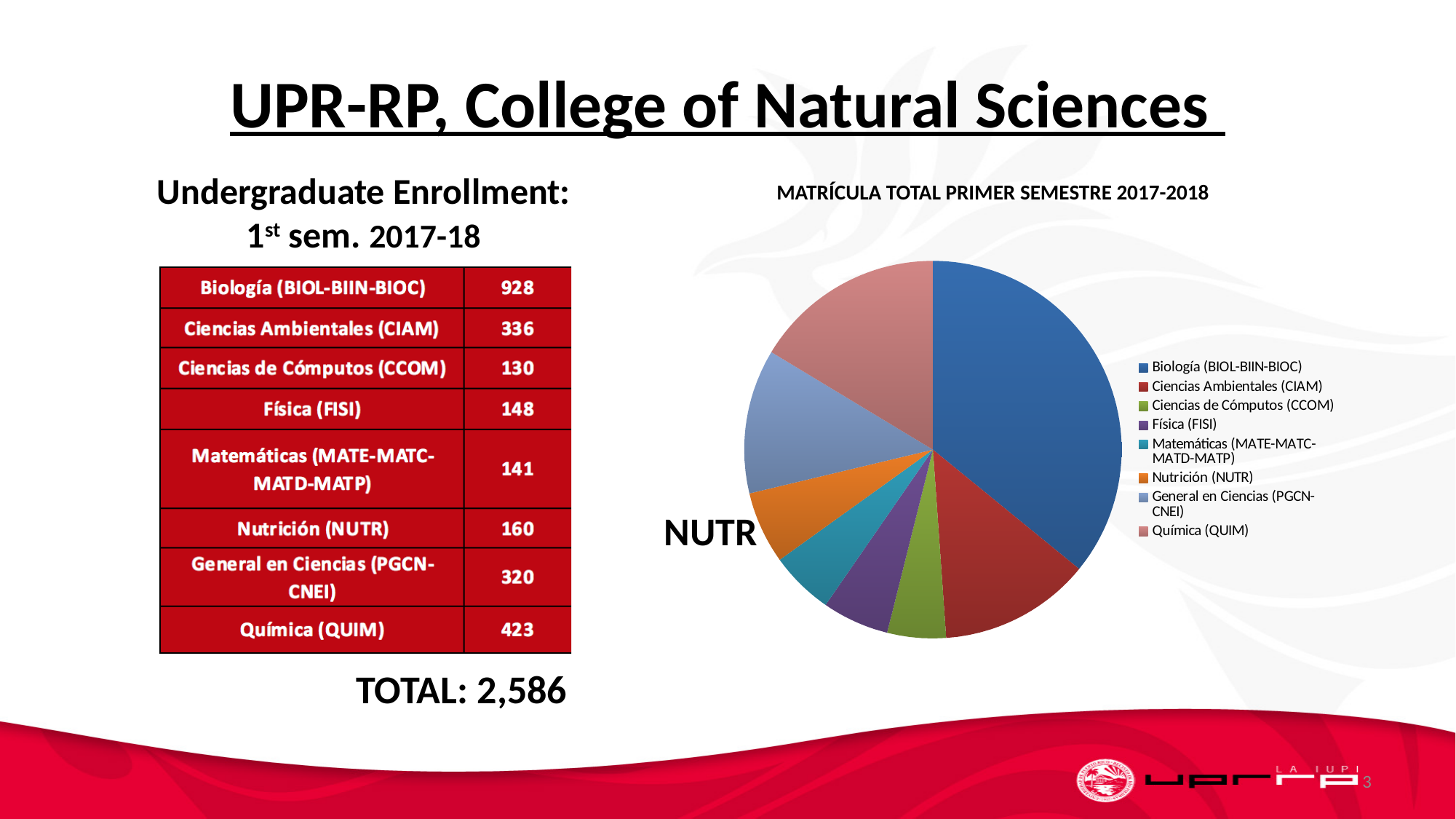
What kind of chart is shown on the slide? Pie chart How many categories (slices) does the pie chart have? 8 What is the total enrollment across all categories shown? 2,586 What is the enrollment value for Biología (BIOL-BIIN-BIOC)? 928 What is the title of the pie chart? MATRÍCULA TOTAL PRIMER SEMESTRE 2017-2018 Which category has the largest slice in the pie chart? Biología (BIOL-BIIN-BIOC) What colour is the Biología (BIOL-BIIN-BIOC) slice in the pie chart? Blue What is the enrollment value for Nutrición (NUTR)? 160 Which category has the smallest enrollment according to the slide? Ciencias de Cómputos (CCOM) What is the enrollment value for Química (QUIM)? 423 What is the difference between the enrollment for Biología (BIOL-BIIN-BIOC) and Química (QUIM)? 505 Which slice is larger, Química (QUIM) or Ciencias Ambientales (CIAM)? Química (QUIM)